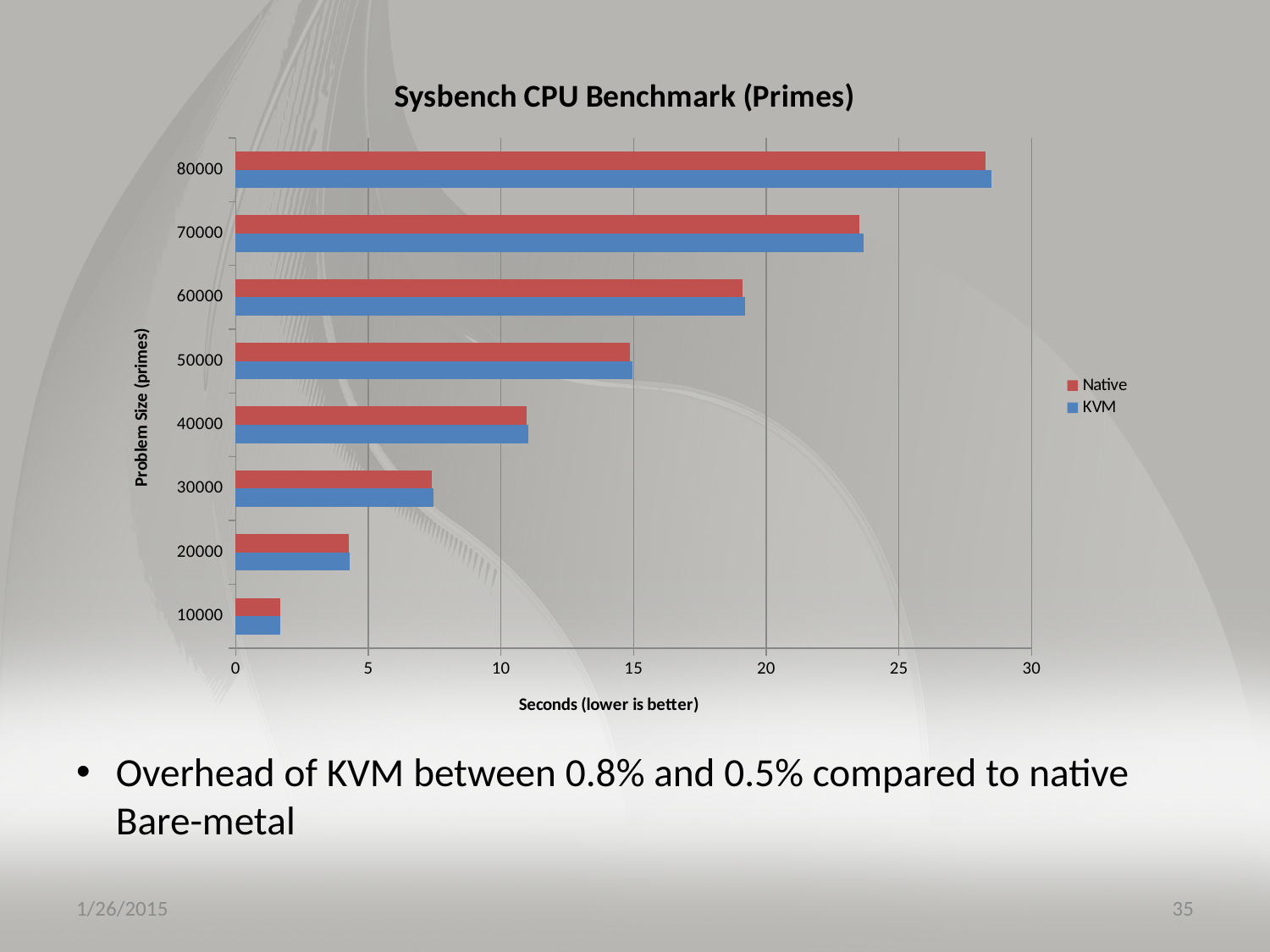
Do the values rise or fall as the problem size increases from 10000 to 80000? rise Is the Native value for 60000 greater or less than 20? less What is the label of the horizontal axis? Seconds (lower is better) Which problem size has the highest Native value? 80000 Is the Native value for 80000 greater or less than 25? greater What is the title of the chart? Sysbench CPU Benchmark (Primes) How many series does the legend list? 2 Is the KVM value for 10000 greater or less than 5? less Which problem size has the lowest KVM value? 10000 What kind of chart is shown on the slide? bar chart How many problem sizes are plotted on the y axis? 8